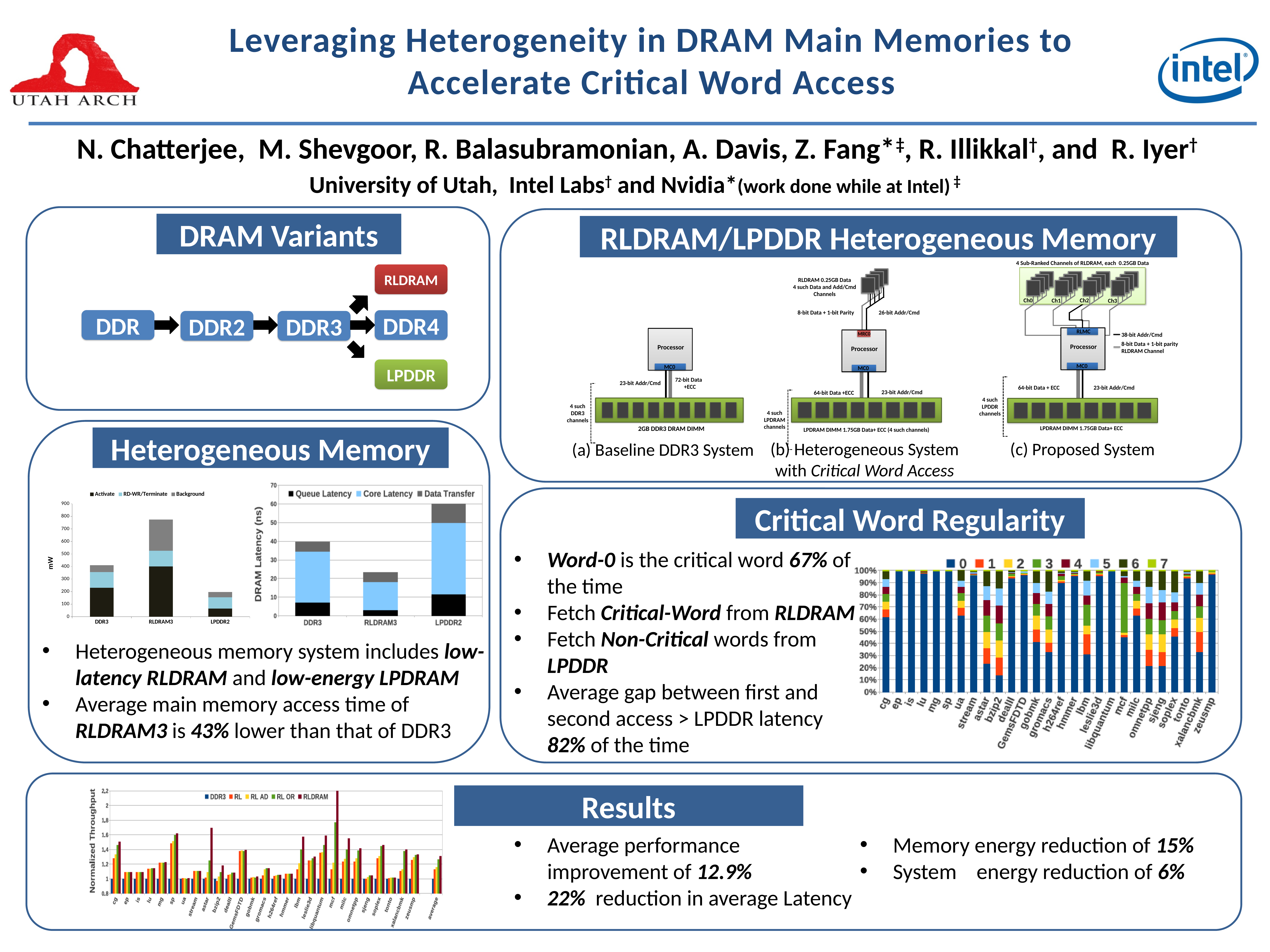
In the DRAM Latency (ns) chart, which memory type has the lowest total latency? RLDRAM3 In the Normalized Throughput chart, how many series does the legend list? 5 In the DRAM Latency (ns) chart, which memory type has the highest total latency? LPDDR2 In the Critical Word Regularity chart, how many series does the legend list? 8 In the mW power chart under Heterogeneous Memory, which memory type has the lowest total power? LPDDR2 In the DRAM Latency (ns) chart, what kind of chart is it? stacked bar chart In the mW power chart under Heterogeneous Memory, how many series does the legend list? 3 In the mW power chart under Heterogeneous Memory, is the total value for RLDRAM3 greater or less than 700? greater In the mW power chart under Heterogeneous Memory, which memory type has the highest total power? RLDRAM3 In the Normalized Throughput chart, for which benchmark does the RLDRAM bar reach its highest value? mcf In the DRAM Latency (ns) chart, what are the three legend entries? Queue Latency, Core Latency, Data Transfer In the DRAM Latency (ns) chart, is the total value for RLDRAM3 greater or less than 30? less